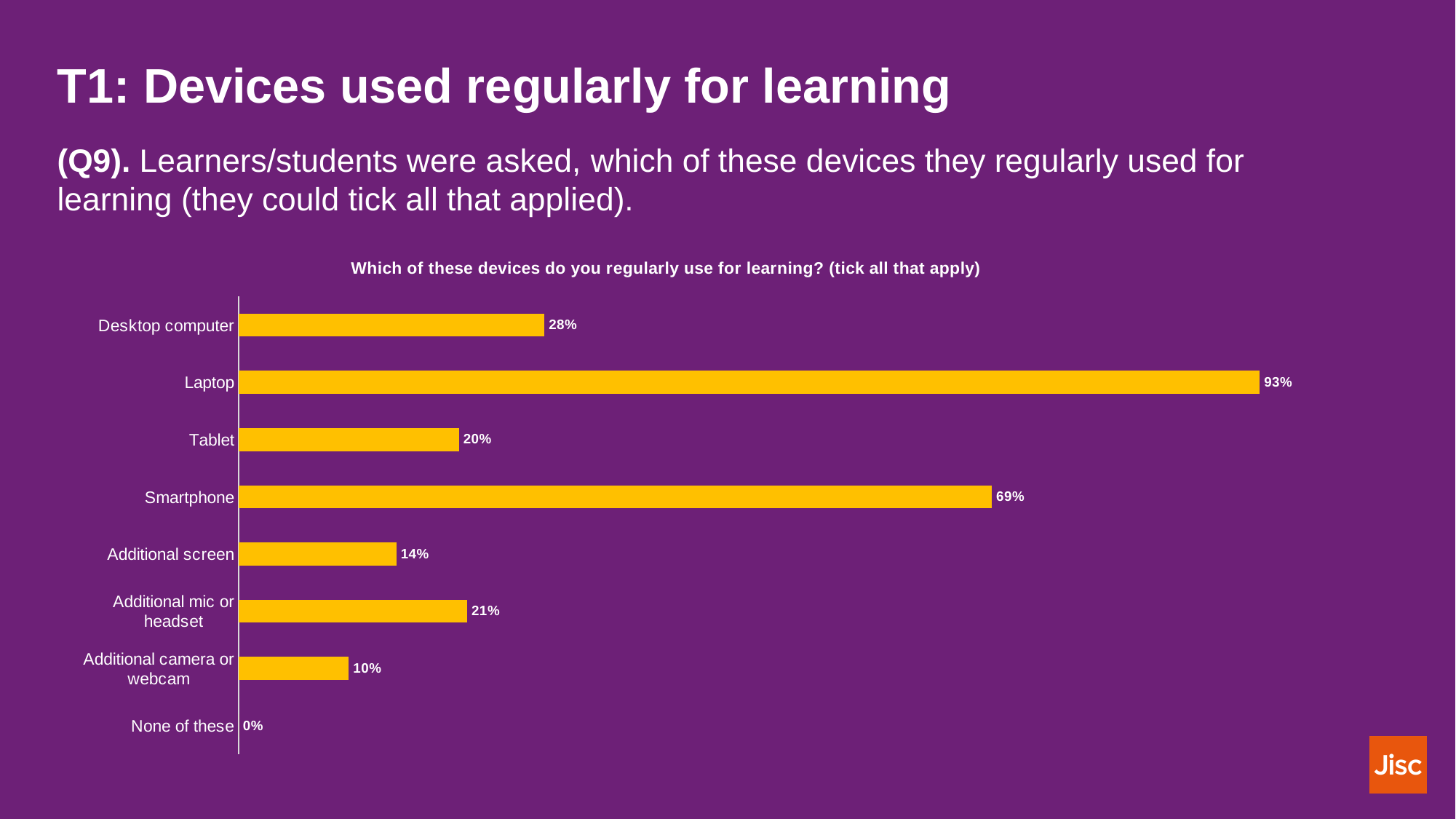
What is the title of the chart? Which of these devices do you regularly use for learning? (tick all that apply) Which is larger, the value for Tablet or the value for Additional mic or headset? Additional mic or headset What kind of chart is shown on the slide? Bar chart What is the value shown for Additional camera or webcam? 10% Which category has the lowest value in the chart? None of these Which device has the highest percentage of regular use for learning? Laptop What is the difference between the percentages for Desktop computer and Tablet? 8% What is the difference between the percentages for Laptop and Smartphone? 24% What percentage of learners regularly use a smartphone for learning? 69% How many device categories are shown in the chart? 8 What percentage of learners regularly use a laptop for learning? 93% What is the value shown for Additional mic or headset? 21%